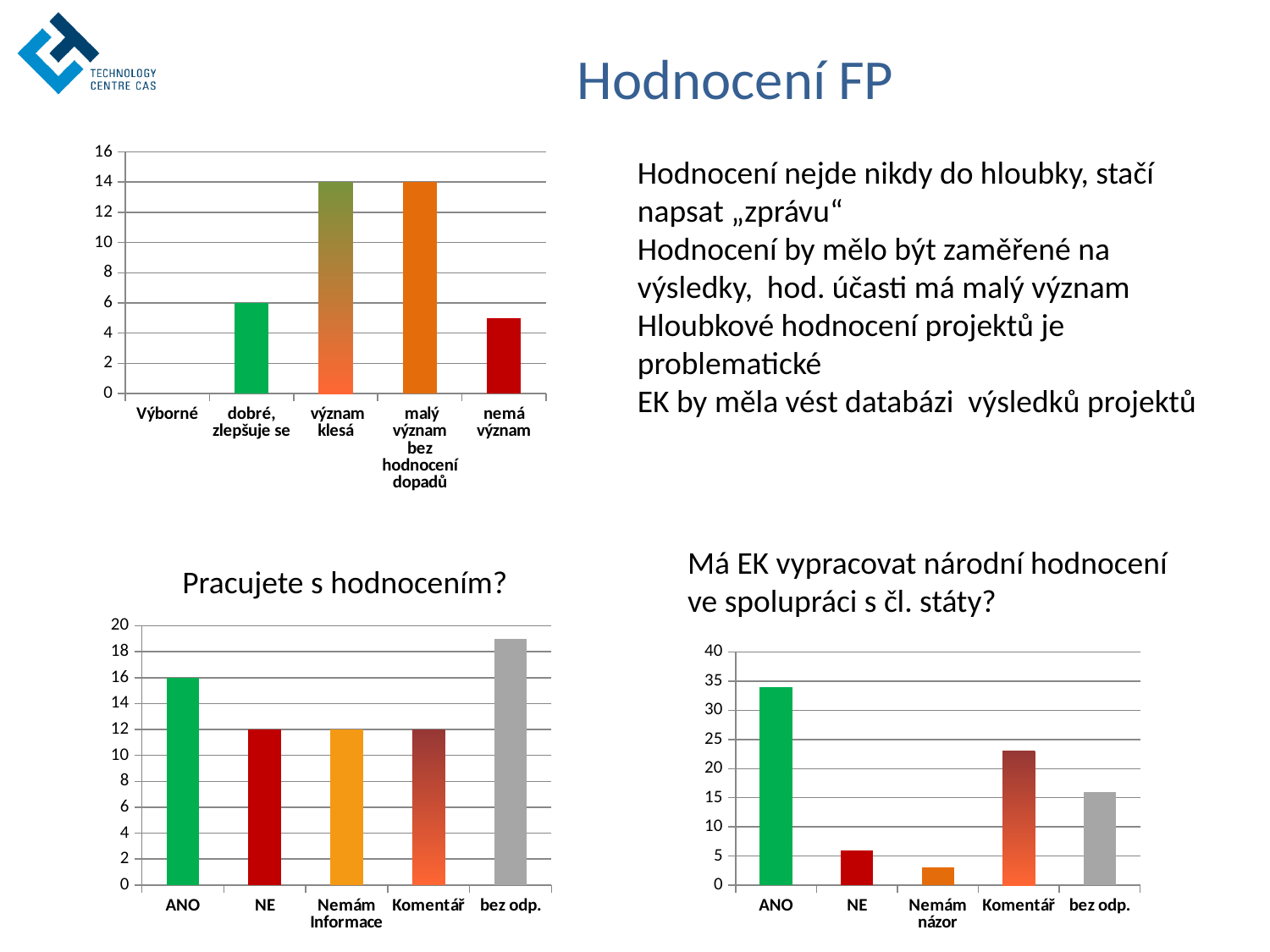
In the top-left chart, is the value for 'nemá význam' greater or less than 6? less In the top-left chart, which category has the lowest value? Výborné In the chart 'Pracujete s hodnocením?', which category has the highest value? bez odp. In the chart 'Pracujete s hodnocením?', what is the value for NE? 12 In the chart 'Pracujete s hodnocením?', is the value for 'bez odp.' greater or less than 18? greater In the chart 'Pracujete s hodnocením?', what is the value for ANO? 16 In the top-left chart, what is the value for 'dobré, zlepšuje se'? 6 In the top-left chart, how many categories are shown on the x axis? 5 In the chart 'Má EK vypracovat národní hodnocení ve spolupráci s čl. státy?', which category has the highest value? ANO In the top-left chart, what is the value for 'význam klesá'? 14 In the chart 'Má EK vypracovat národní hodnocení ve spolupráci s čl. státy?', is the value for Komentář greater or less than 20? greater What kind of chart is the bottom-right chart 'Má EK vypracovat národní hodnocení ve spolupráci s čl. státy?'? bar chart